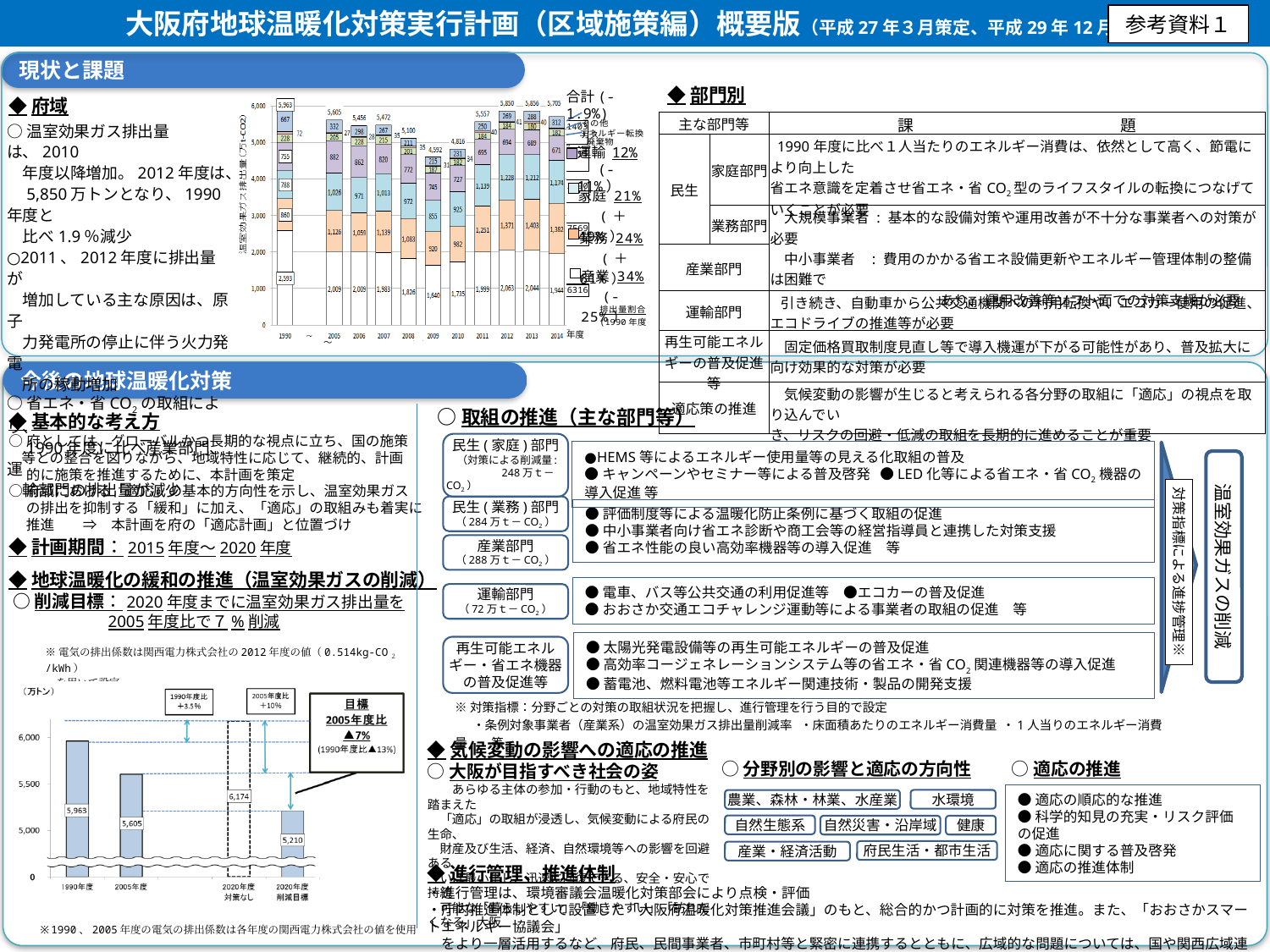
In the bottom-left bar chart, what is the value for 1990年度? 5,963 In the top stacked bar chart of greenhouse gas emissions, which year has the highest total? 1990 In the top stacked bar chart of greenhouse gas emissions, what is the total for 2012? 5,850 In the top stacked bar chart of greenhouse gas emissions, which year has the lowest total? 2009 In the bottom-left bar chart, which bar is the lowest? 2020年度 削減目標 What kind of chart is the bottom-left chart? Bar chart In the top stacked bar chart of greenhouse gas emissions, which year has the larger total, 2013 or 2014? 2013 How many years are plotted in the top stacked bar chart of greenhouse gas emissions? 11 How many bars are shown in the bottom-left bar chart? 4 In the bottom-left bar chart, what is the value for 2020年度 削減目標? 5,210 In the bottom-left bar chart, what is the difference between the 1990年度 value and the 2005年度 value? 358 In the bottom-left bar chart, which bar is the highest? 2020年度 対策なし